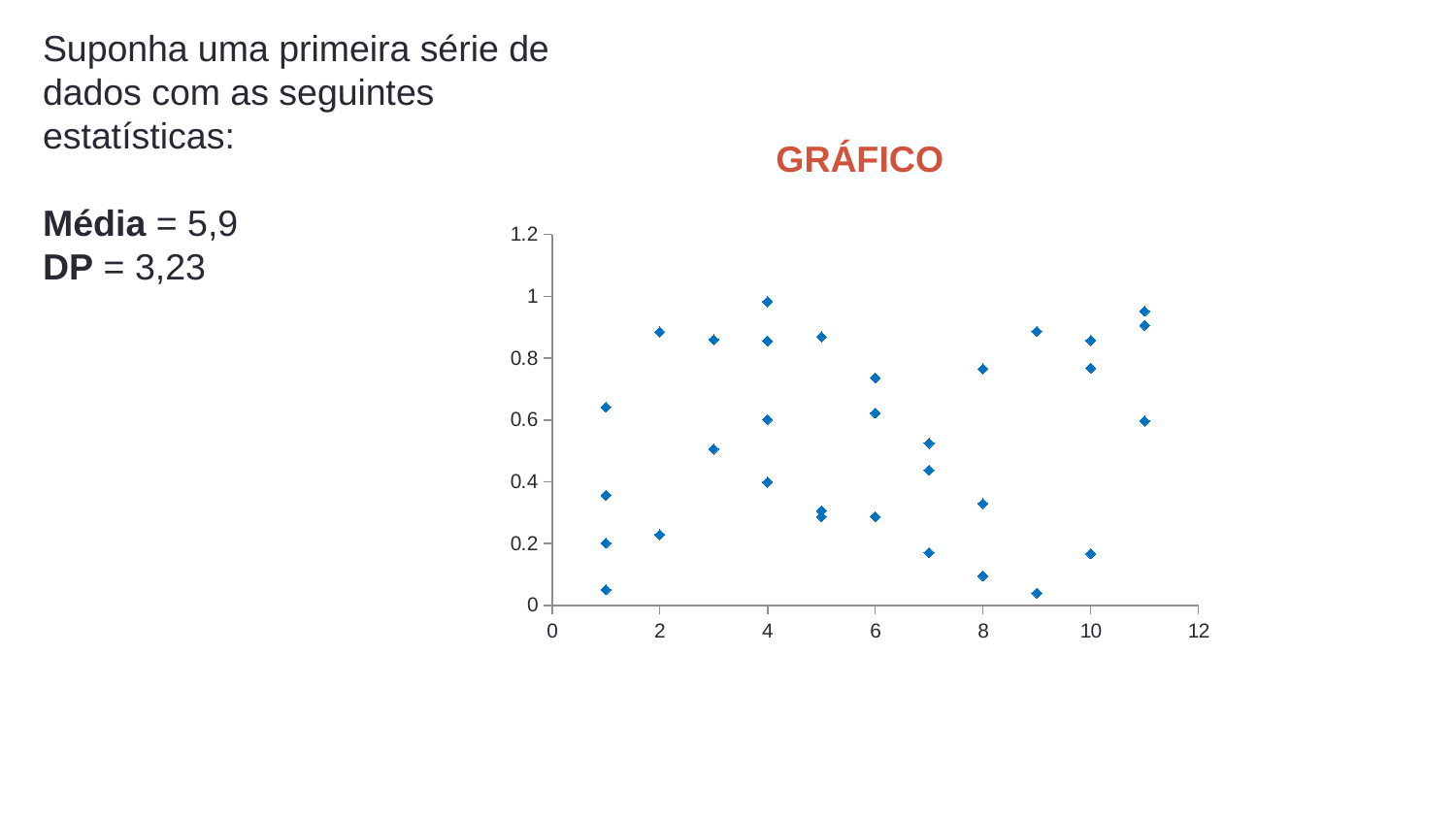
Is the lowest point at x = 1 greater or less than 0.2? less How many distinct x positions have plotted points in the chart? 11 What is the highest value shown on the x axis of the chart? 12 What is the highest value shown on the y axis of the chart? 1.2 How many points are plotted at x = 9? 2 How many points are plotted at x = 2? 2 What kind of chart is shown on the slide? scatter chart What is the title of the chart? GRÁFICO Is the lowest point at x = 9 greater or less than 0.2? less Is the highest point at x = 3 greater or less than 0.6? greater